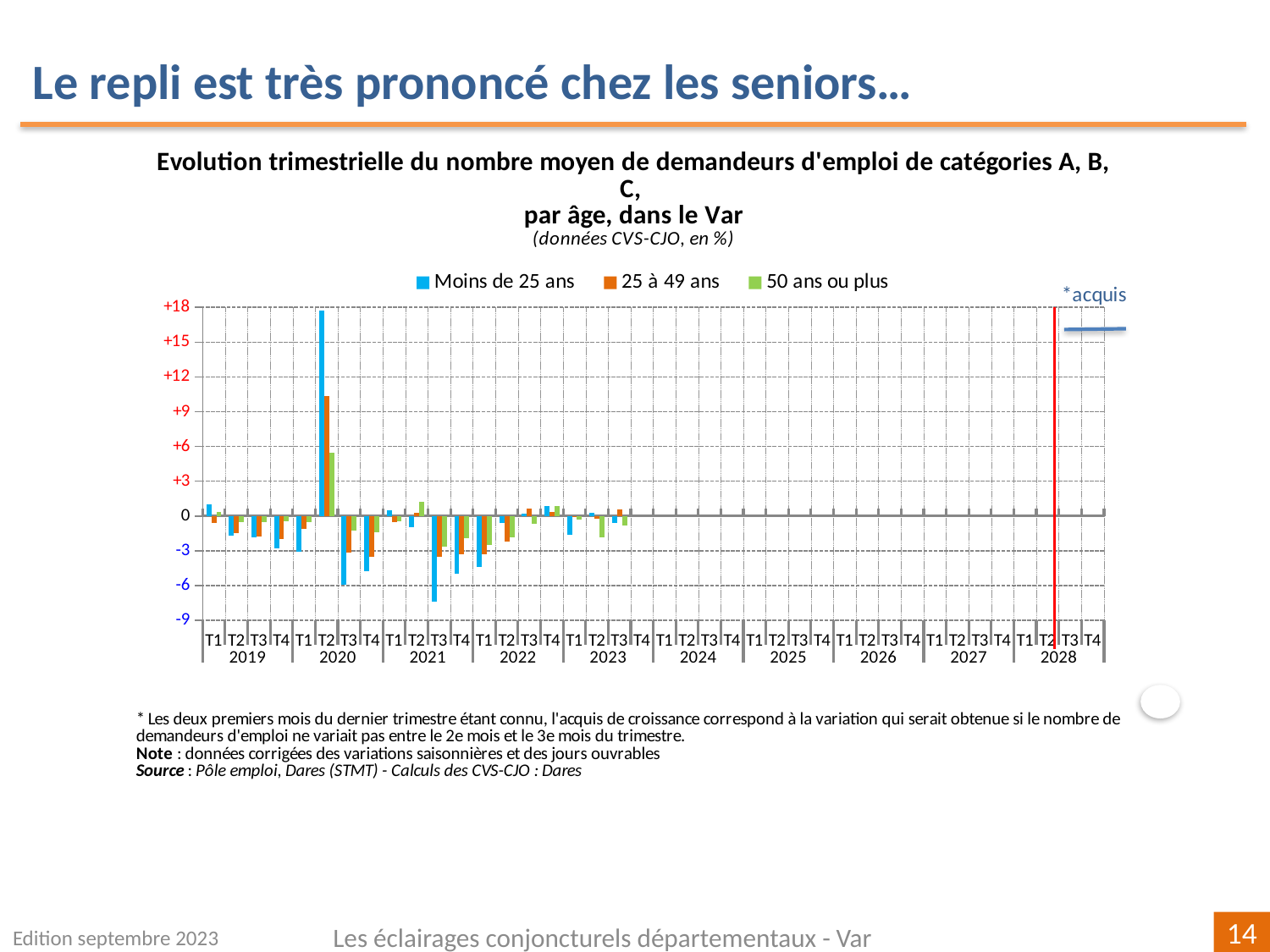
In which quarter does the 'Moins de 25 ans' series reach its lowest value? T3 2021 In which quarter does the 'Moins de 25 ans' series reach its highest value? T2 2020 Which series are listed in the legend? Moins de 25 ans, 25 à 49 ans, 50 ans ou plus Which series has the highest value in T2 2020? Moins de 25 ans Is the value for '50 ans ou plus' in T2 2020 greater or less than +3? greater Is the value for 'Moins de 25 ans' in T2 2020 greater or less than +15? greater What kind of chart is shown on the slide? bar chart Is the value for 'Moins de 25 ans' in T3 2021 greater or less than -6? less How many years are labelled along the x axis? 10 What is the unit of the data according to the chart subtitle? données CVS-CJO, en % How many series does the legend list? 3